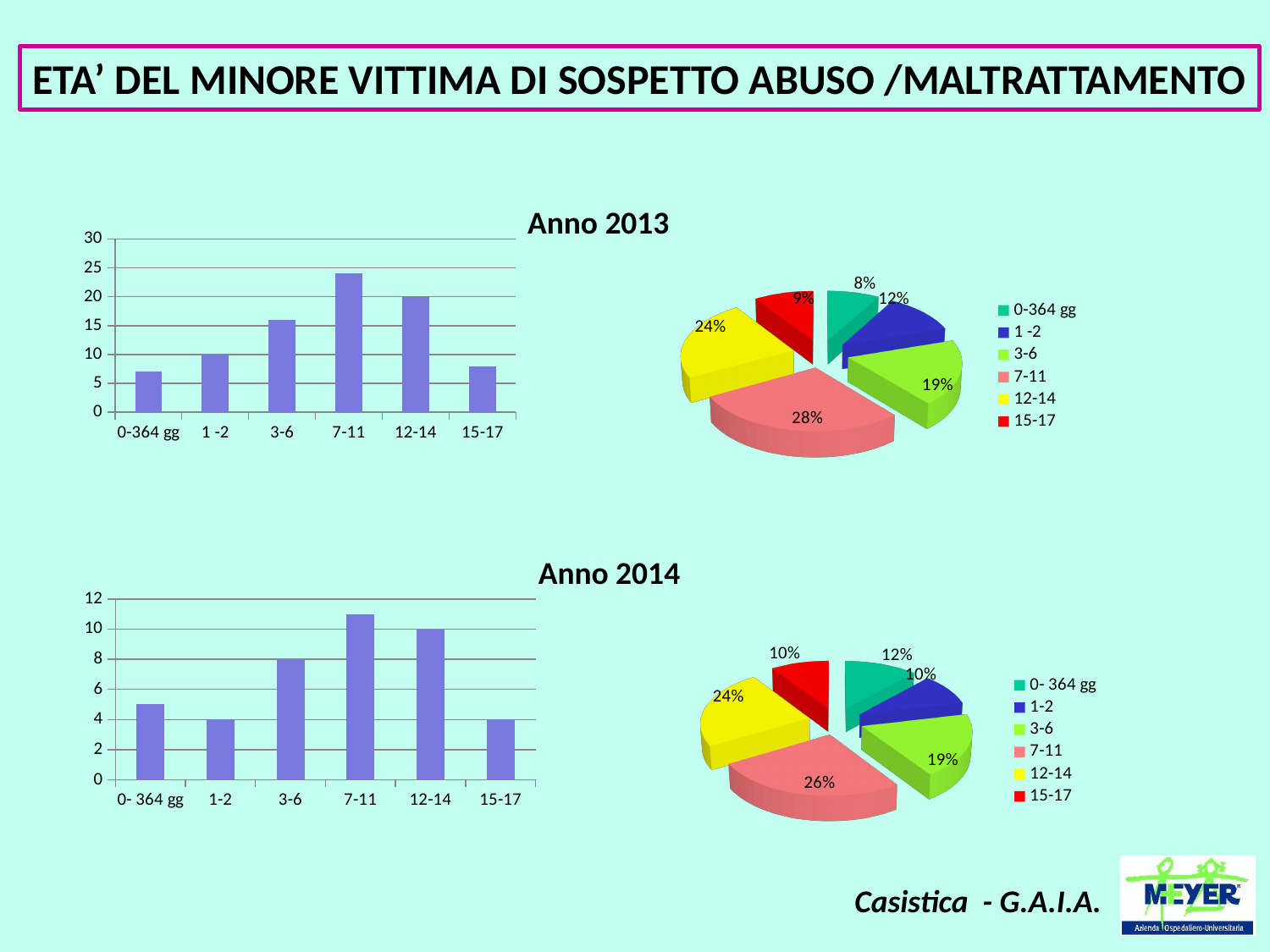
What type of chart is the Anno 2013 chart on the left of the slide? bar chart In the Anno 2014 bar chart, is the value for 7-11 greater or less than 10? greater In the Anno 2013 bar chart, which age group has the tallest bar? 7-11 In the Anno 2014 pie chart, which age group has the largest share? 7-11 In the Anno 2014 bar chart, what is the value for the 3-6 age group? 8 In the Anno 2013 pie chart, which age group has the smallest share? 0-364 gg How many age groups are shown in the Anno 2014 bar chart? 6 In the Anno 2013 pie chart, what share does the 7-11 age group have? 28% In the Anno 2014 pie chart, what share does the 12-14 age group have? 24% In the Anno 2013 bar chart, is the value for 7-11 greater or less than 20? greater In the Anno 2013 pie chart, what is the difference between the shares of the 7-11 and 3-6 age groups? 9% In the Anno 2014 pie chart, which is larger: the share for 0-364 gg or the share for 1-2? 0-364 gg